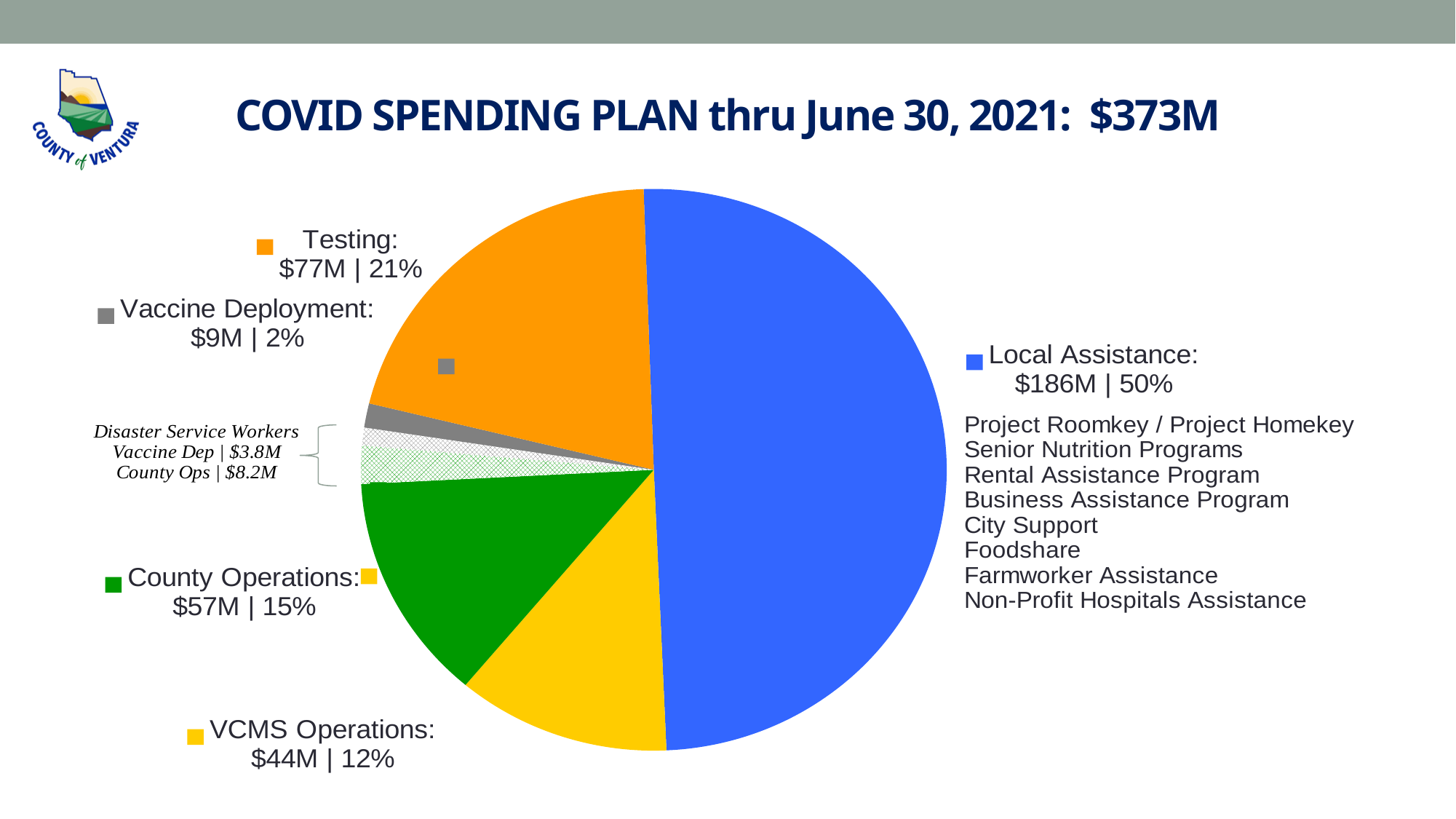
What is the dollar amount for County Operations? $57M What is the dollar amount for Local Assistance? $186M Which is larger, County Operations or VCMS Operations? County Operations Which labeled category has the smallest share of the pie? Vaccine Deployment What is the difference in dollars between Testing and VCMS Operations? $33M What percentage of the spending plan is Testing? 21% What is the dollar amount for Vaccine Deployment? $9M Which category has the largest share of the pie? Local Assistance What percentage of the spending plan is VCMS Operations? 12% What kind of chart is shown on the slide? Pie chart What is the total spending plan amount shown in the chart title? $373M What is the Disaster Service Workers amount for County Ops? $8.2M